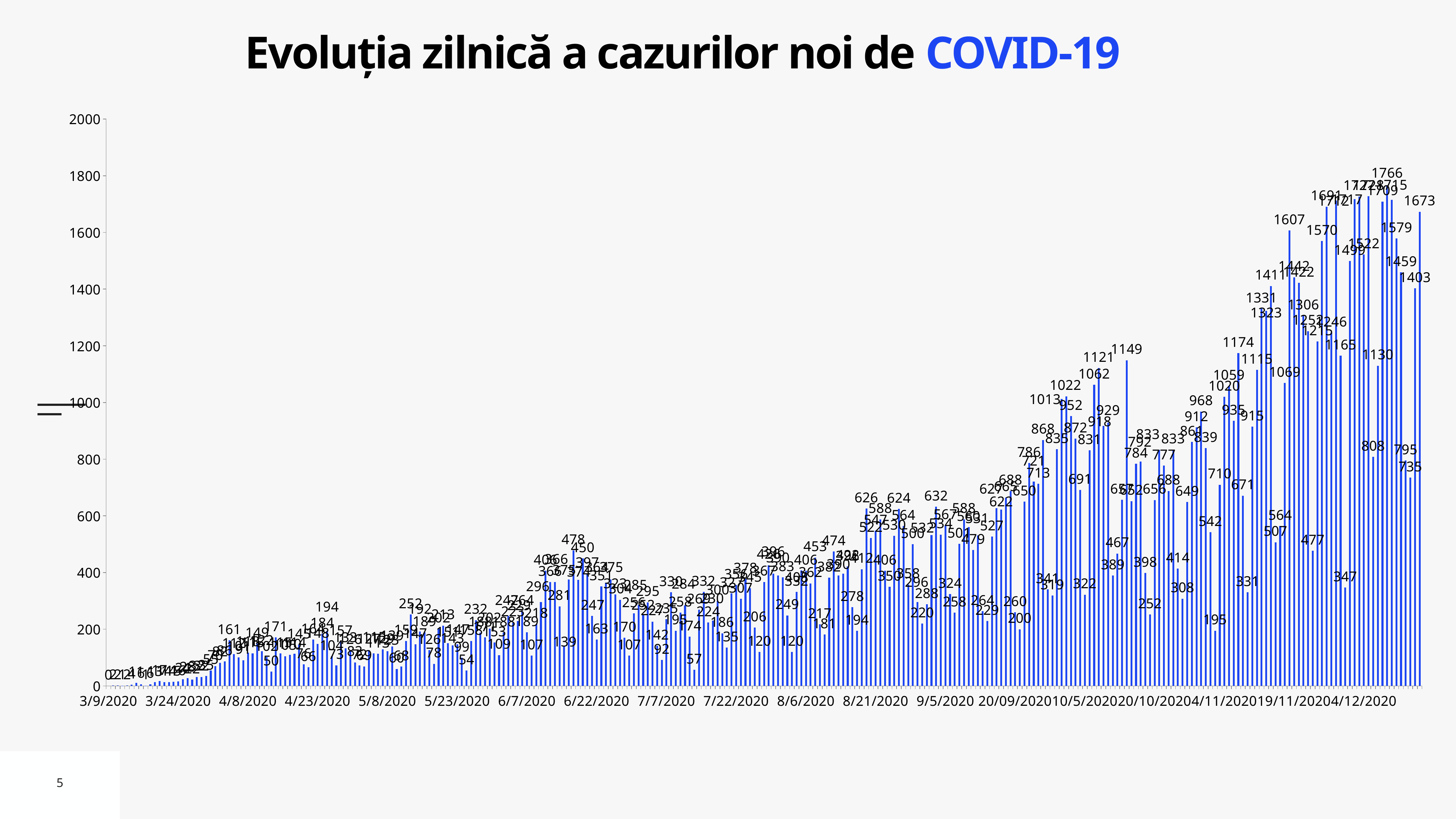
What is the first date label on the x axis? 3/9/2020 What is the highest value shown on the y axis? 2000 Are the bars around 7/7/2020 greater or less than 400? less What is the value of the rightmost bar on the chart? 1673 What is the highest value labeled on the chart? 1766 How many date labels are shown on the x axis? 19 Which is larger: the peak value near 6/22/2020 (478) or the peak value near 8/21/2020 (626)? the peak near 8/21/2020 (626) Is the highest bar on the chart greater or less than 1800? less What is the title of the chart? Evoluția zilnică a cazurilor noi de COVID-19 Overall, do the values rise or fall from left to right along the x axis? rise What is the difference between the highest labeled value (1766) and the rightmost bar (1673)? 93 What kind of chart is shown on the slide? bar chart